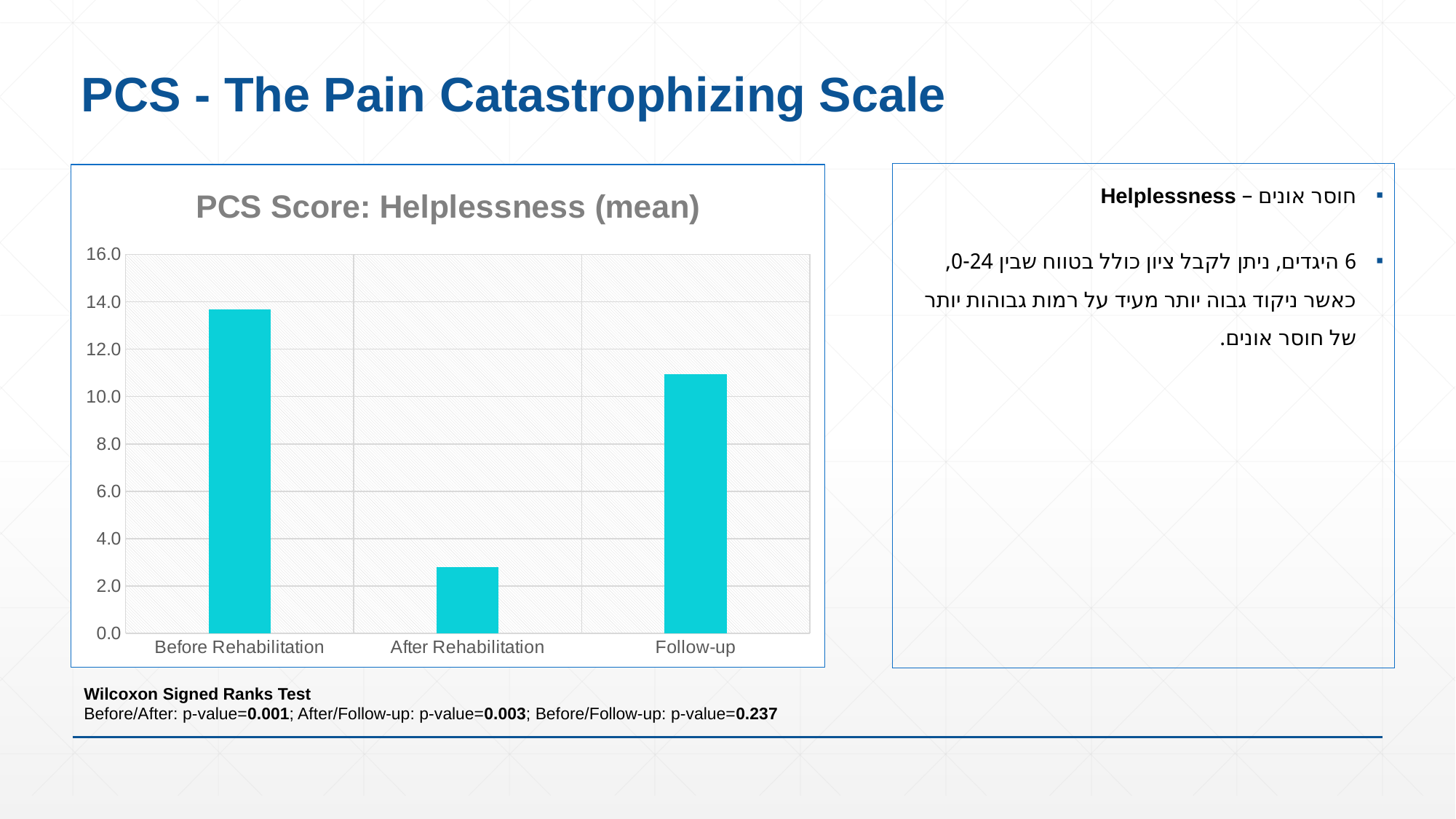
Is the value for Follow-up greater or less than 12.0? less Which is larger, the value for Before Rehabilitation or the value for Follow-up? Before Rehabilitation How many categories are plotted on the x axis of the chart? 3 Which category has the highest mean Helplessness score? Before Rehabilitation What is the maximum value shown on the y axis of the chart? 16.0 What kind of chart is shown on the slide? bar chart Which category has the lowest mean Helplessness score? After Rehabilitation Is the value for After Rehabilitation greater or less than 4.0? less What is the title of the chart? PCS Score: Helplessness (mean) Is the value for Follow-up greater or less than 10.0? greater Which is larger, the value for After Rehabilitation or the value for Follow-up? Follow-up